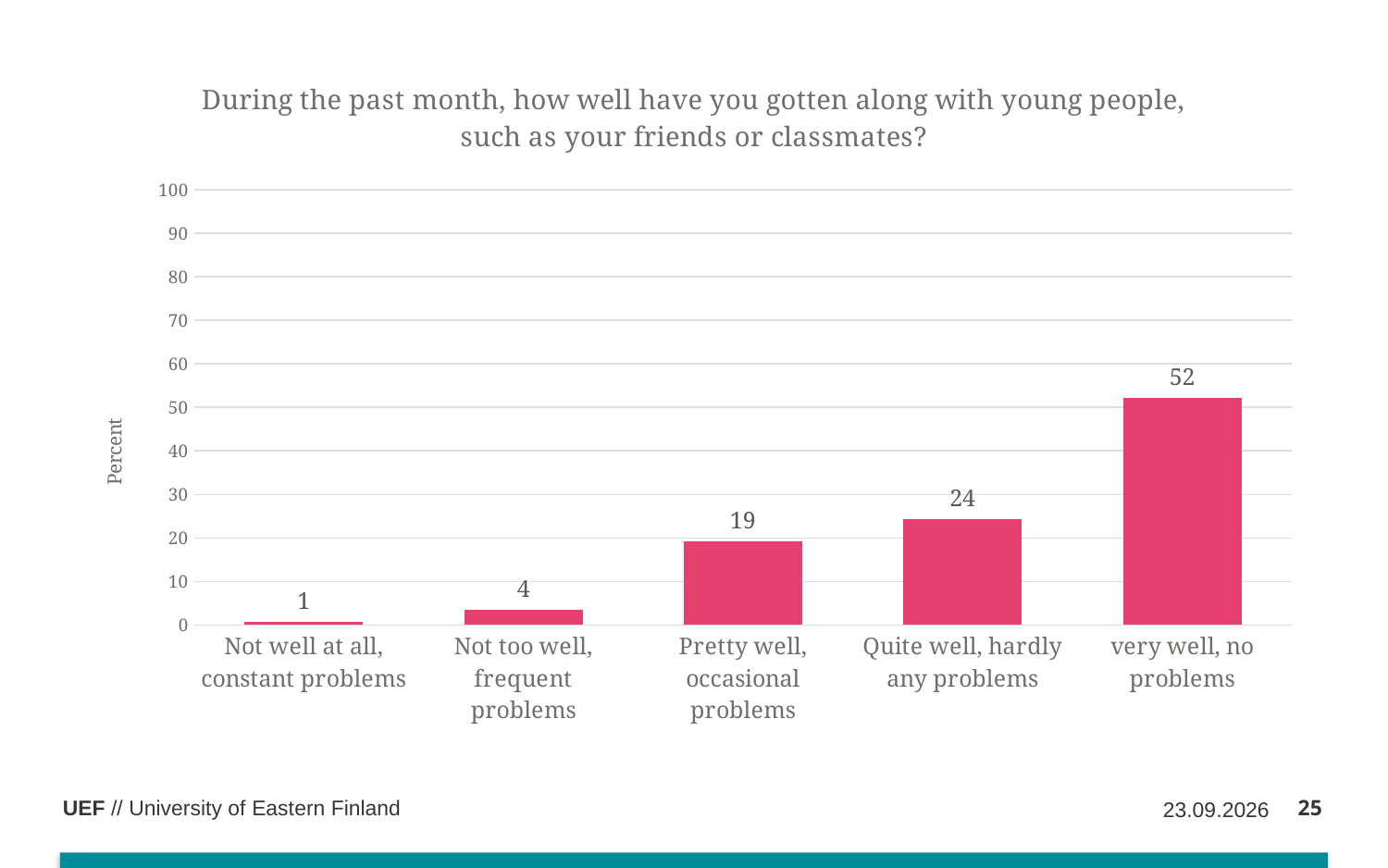
Which category has the lowest value? Not well at all, constant problems What is the value for "Not too well, frequent problems"? 4 Is the value for "very well, no problems" greater or less than 50? greater What is the difference between the values for "very well, no problems" and "Quite well, hardly any problems"? 28 What kind of chart is shown on the slide? bar chart Do the values rise or fall from left to right along the x axis? rise Which is larger: the value for "Pretty well, occasional problems" or "Quite well, hardly any problems"? Quite well, hardly any problems How many categories are shown on the x axis? 5 Which category has the highest value? very well, no problems What is the value for "Pretty well, occasional problems"? 19 What is the label of the y axis? Percent What is the value for "very well, no problems"? 52